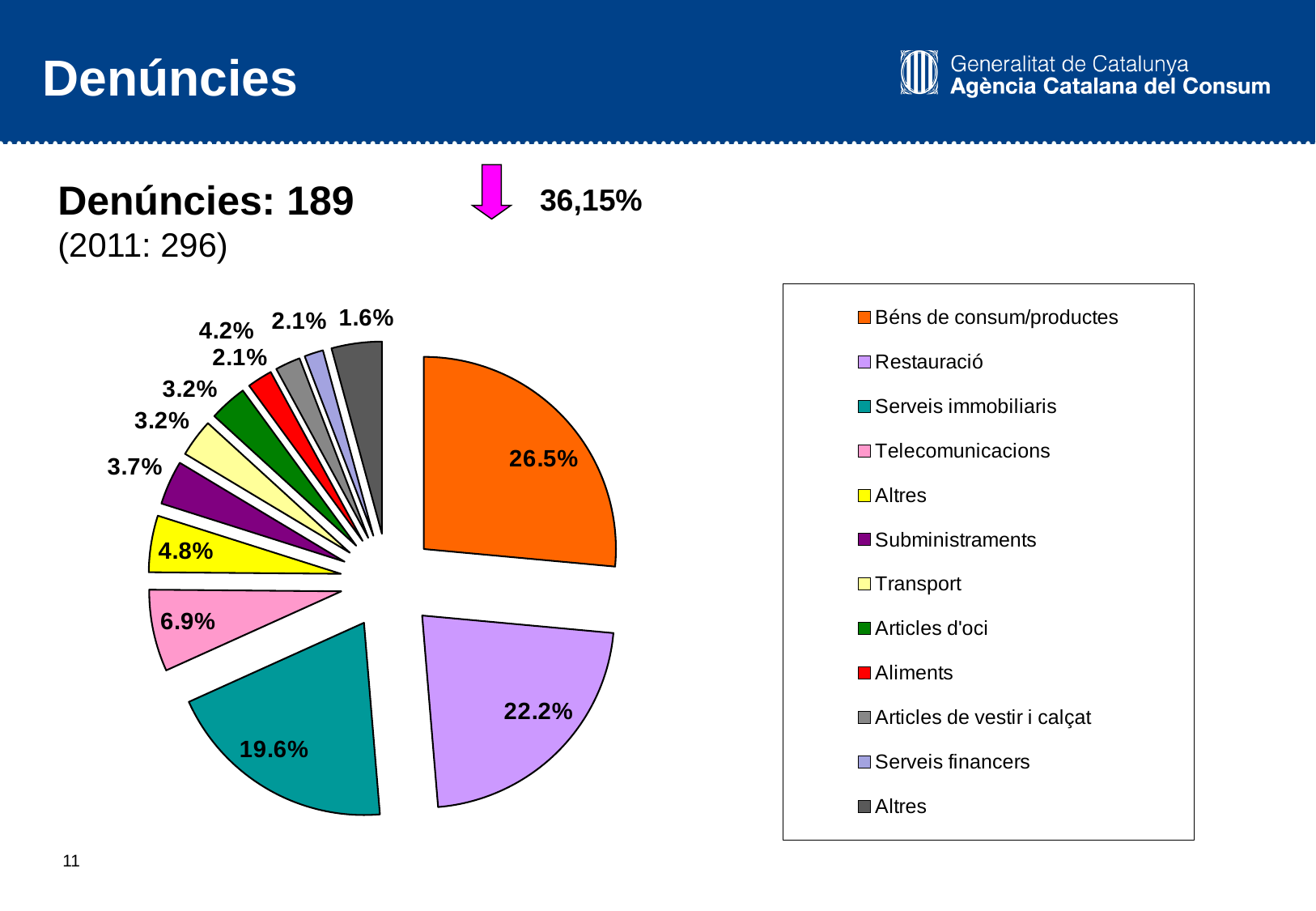
What percentage of the pie chart corresponds to Serveis immobiliaris? 19.6% What type of chart is shown on the slide? pie chart According to the slide, how many denúncies were there in 2011? 296 What percentage of the pie chart corresponds to Subministraments? 3.7% What percentage of the pie chart corresponds to Restauració? 22.2% What is the difference in percentage points between Béns de consum/productes and Restauració? 4.3 What percentage of the pie chart corresponds to Béns de consum/productes? 26.5% Which has a larger share of the pie chart, Serveis immobiliaris or Telecomunicacions? Serveis immobiliaris How many entries does the legend of the pie chart list? 12 Which category has the largest share of the pie chart? Béns de consum/productes What percentage of the pie chart corresponds to Telecomunicacions? 6.9% What is the smallest percentage shown on the pie chart? 1.6%